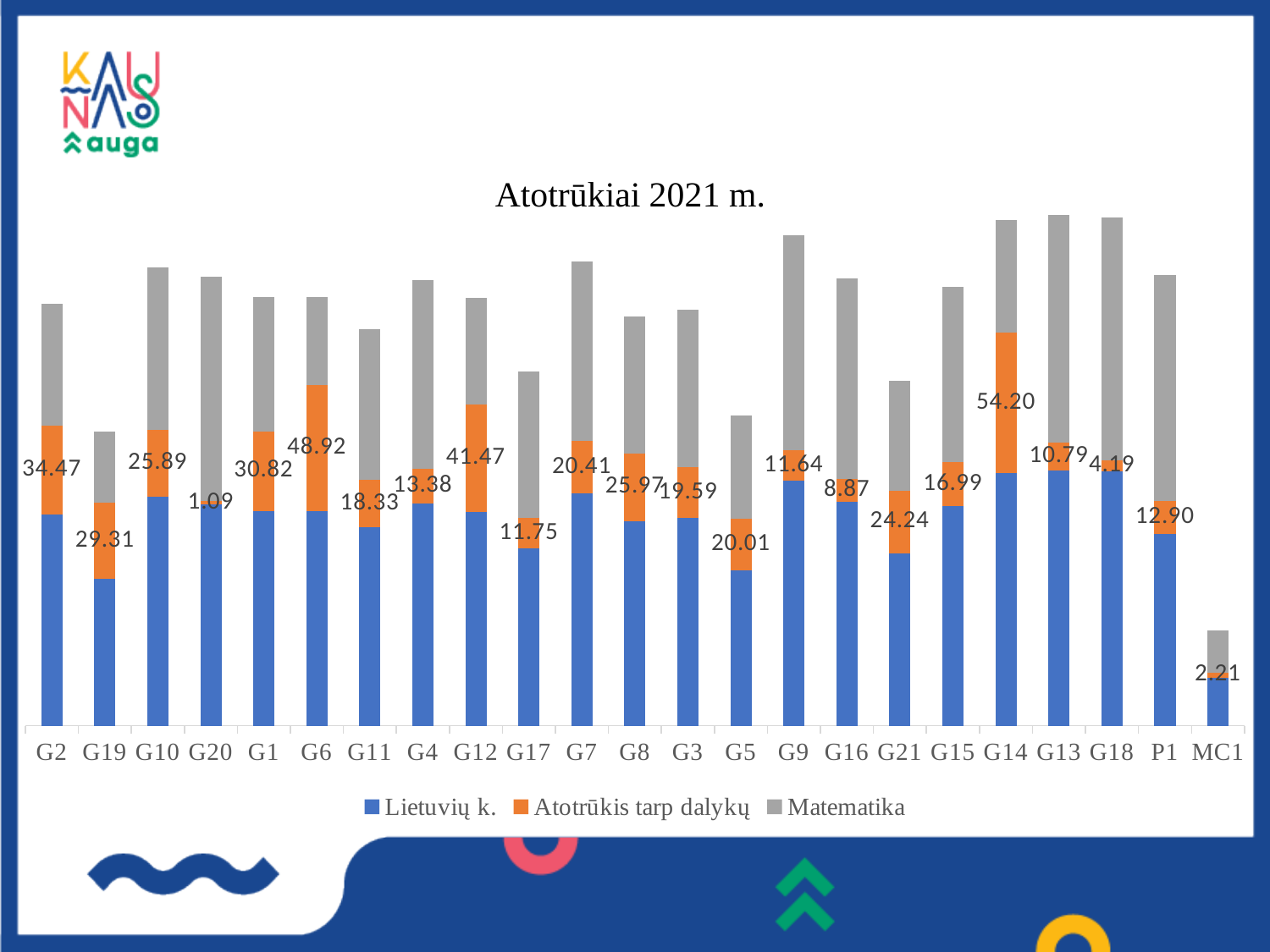
What kind of chart is shown on the slide? stacked bar chart Which has a larger Atotrūkis tarp dalykų value, G12 or G1? G12 How many categories are shown on the x axis? 23 How many series does the legend list? 3 What is the difference between the Atotrūkis tarp dalykų values for G14 and G20? 53.11 What is the title of the chart? Atotrūkiai 2021 m. Which category has the shortest total stacked bar? MC1 What is the value of Atotrūkis tarp dalykų for G20? 1.09 What is the value of Atotrūkis tarp dalykų for G14? 54.20 What is the value of Atotrūkis tarp dalykų for MC1? 2.21 Which category has the lowest value for Atotrūkis tarp dalykų? G20 Which category has the highest value for Atotrūkis tarp dalykų? G14